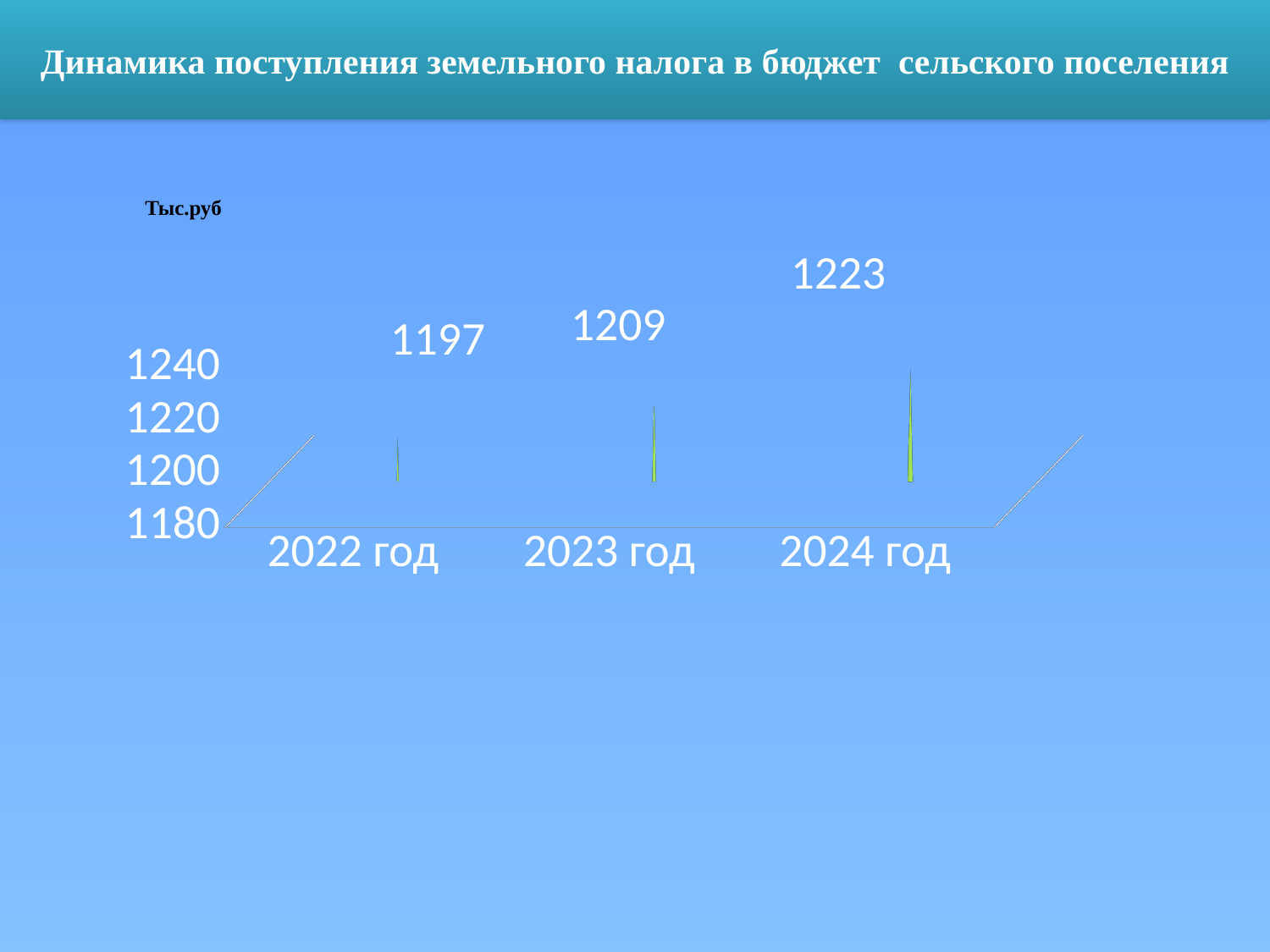
Which year has the lowest value on the chart? 2022 год What unit of measurement is indicated above the chart? Тыс.руб What is the difference between the values for 2023 год and 2022 год? 12 Which year has the highest value on the chart? 2024 год What kind of chart is shown on the slide? bar chart Which is larger, the value for 2023 год or the value for 2024 год? 2024 год What is the value shown for 2024 год? 1223 What is the land tax revenue value shown for 2022 год? 1197 What is the value shown for 2023 год? 1209 What is the difference between the values for 2024 год and 2022 год? 26 Do the values rise or fall from 2022 год to 2024 год? rise How many years are shown on the x axis of the chart? 3